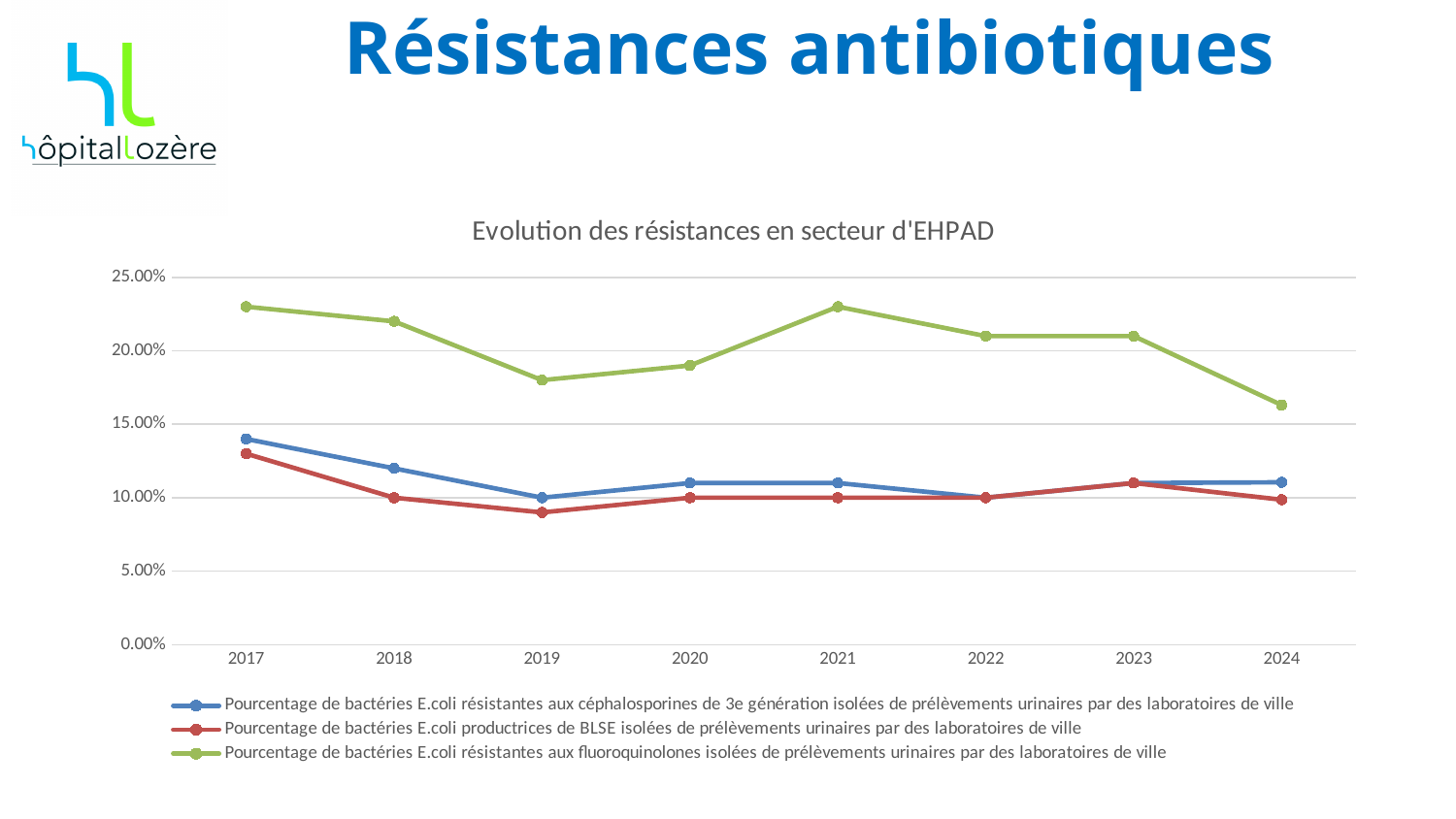
Does the fluoroquinolones series rise or fall from 2021 to 2024? fall How many series does the legend list? 3 In which year is the fluoroquinolones series at its lowest? 2024 What is the title of the chart? Evolution des résistances en secteur d'EHPAD Is the value for the fluoroquinolones series in 2017 greater or less than 20.00%? greater Is the value for the fluoroquinolones series in 2019 greater or less than 20.00%? less In 2018, which series has the larger value: céphalosporines de 3e génération or BLSE? céphalosporines de 3e génération How many years are shown on the x axis? 8 Is the value for the céphalosporines de 3e génération series in 2017 greater or less than 10.00%? greater What colour is the line for the fluoroquinolones series? green What kind of chart is shown on the slide? line chart In which year is the céphalosporines de 3e génération series at its highest? 2017